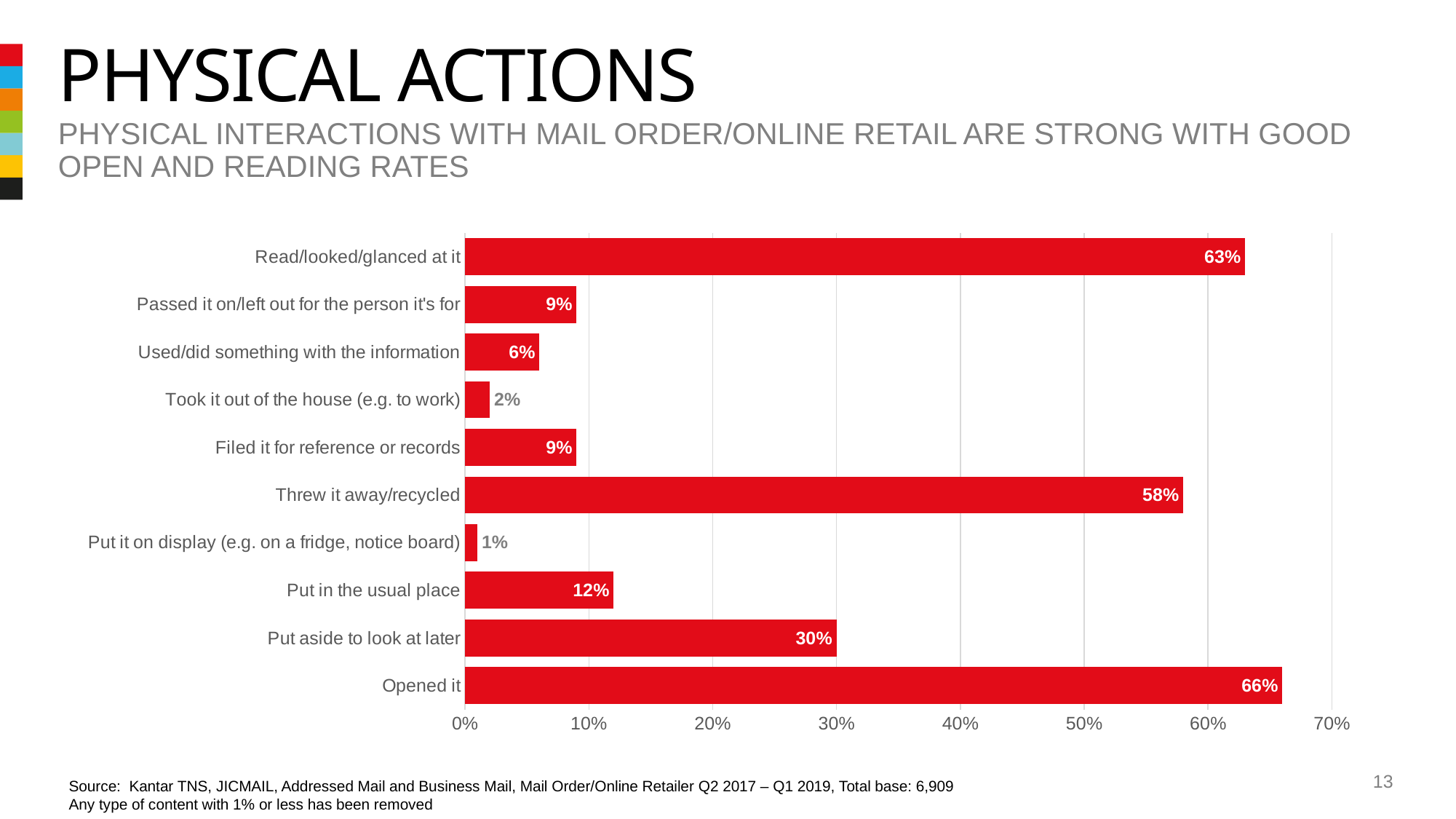
What is the maximum value shown on the horizontal axis? 70% What percentage of respondents said they opened it? 66% What type of chart is shown on the slide? Bar chart Which physical action has the highest percentage? Opened it Which is larger: 'Read/looked/glanced at it' or 'Threw it away/recycled'? Read/looked/glanced at it How many physical actions are shown in the chart? 10 Which physical action has the lowest percentage? Put it on display (e.g. on a fridge, notice board) What is the difference between 'Opened it' and 'Read/looked/glanced at it'? 3% What is the difference between 'Put aside to look at later' and 'Put in the usual place'? 18% What is the value for 'Put aside to look at later'? 30% Is the value for 'Put aside to look at later' greater or less than 20%? greater What is the value for 'Threw it away/recycled'? 58%